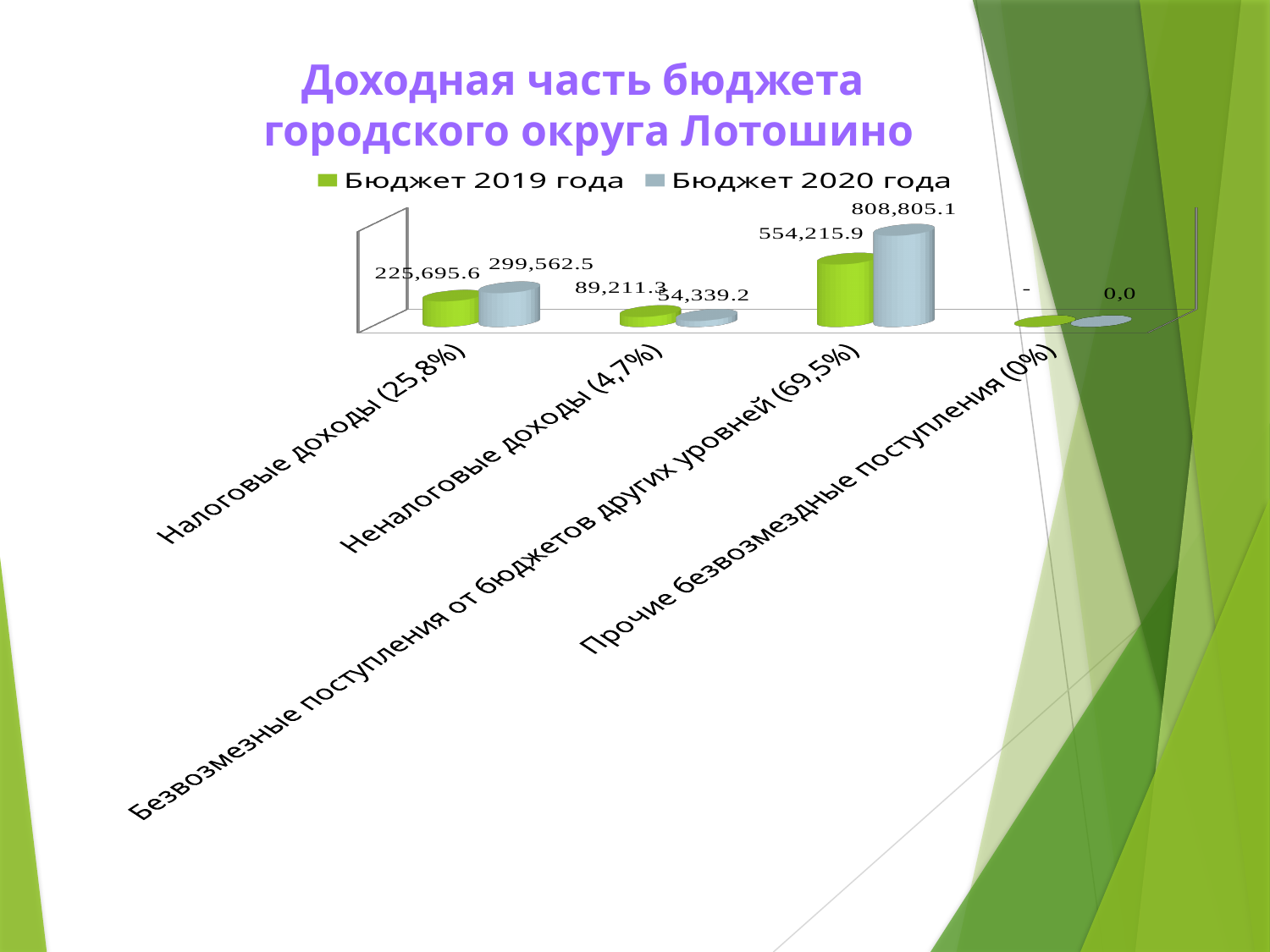
What is the difference between Бюджет 2020 года and Бюджет 2019 года for Налоговые доходы (25,8%)? 73,866.9 What is the title of the chart on the slide? Доходная часть бюджета городского округа Лотошино What is the value of Бюджет 2019 года for Безвозмездные поступления от бюджетов других уровней (69,5%)? 554,215.9 How many series does the legend list? 2 What is the value of Бюджет 2020 года for Безвозмездные поступления от бюджетов других уровней (69,5%)? 808,805.1 What is the value of Бюджет 2020 года for Прочие безвозмездные поступления (0%)? 0,0 What kind of chart is shown on the slide? bar chart For Неналоговые доходы (4,7%), which series has the larger value, Бюджет 2019 года or Бюджет 2020 года? Бюджет 2019 года How many categories are shown on the x axis? 4 Which category has the highest value for Бюджет 2020 года? Безвозмездные поступления от бюджетов других уровней (69,5%) What is the value of Бюджет 2019 года for Налоговые доходы (25,8%)? 225,695.6 What is the value of Бюджет 2020 года for Налоговые доходы (25,8%)? 299,562.5